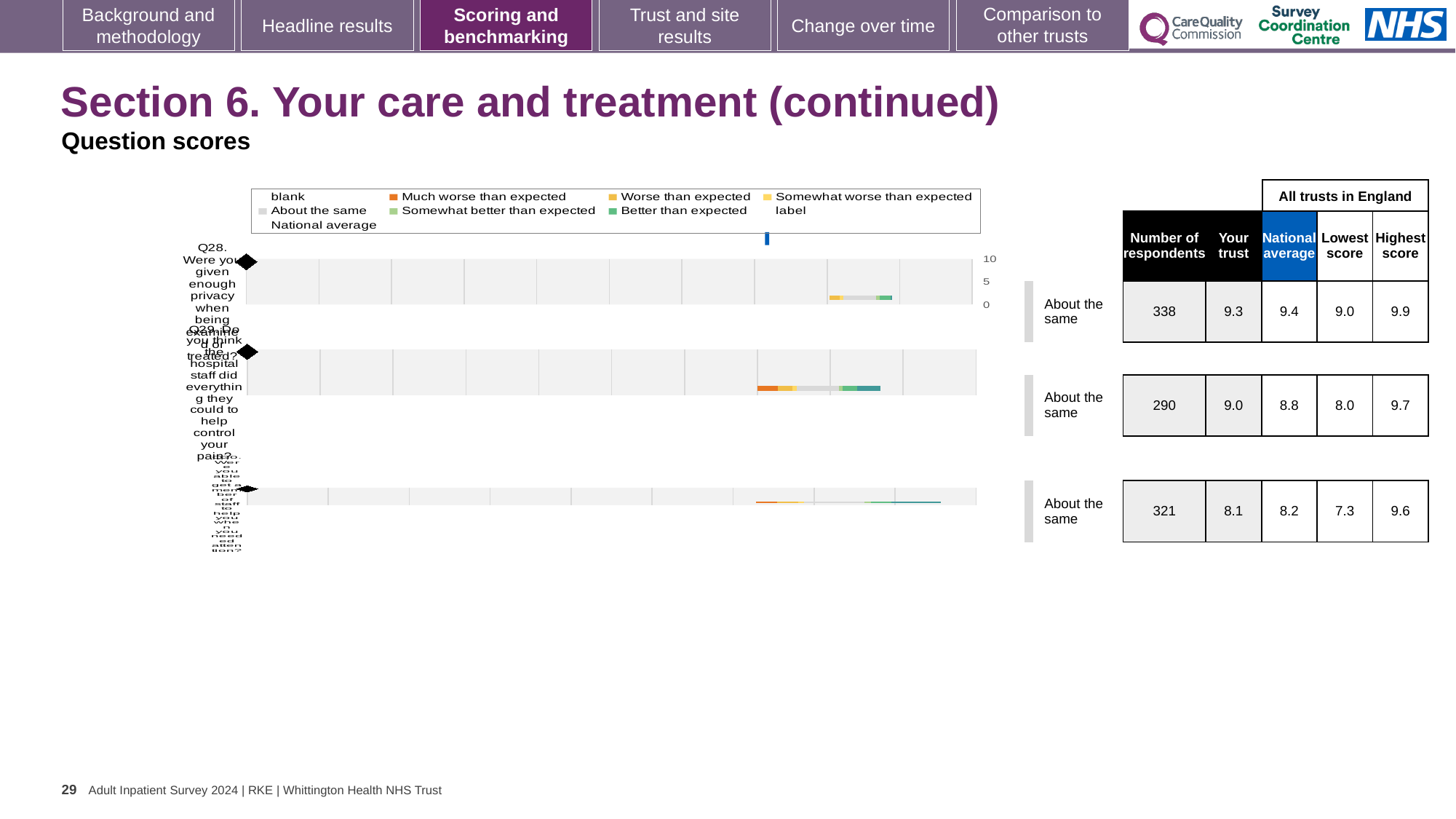
What is the difference between the national average and the 'Your trust' score for Q30? 0.1 Which question has the highest 'Your trust' score on this slide? Q28 What colour represents 'Much worse than expected' in the legend? Orange What is the national average score shown for Q30? 8.2 For Q28, which is larger: the 'Your trust' score or the national average? National average What is the 'Your trust' score for Q29 (staff did everything to help control your pain)? 9.0 How many questions are plotted on this slide's chart? 3 What is the highest score among all trusts in England for Q30? 9.6 How many respondents are listed for Q28 (privacy when being examined or treated)? 338 Which question has the fewest respondents? Q29 What is the lowest score among all trusts in England for Q28? 9.0 What benchmark category is shown for Q29? About the same